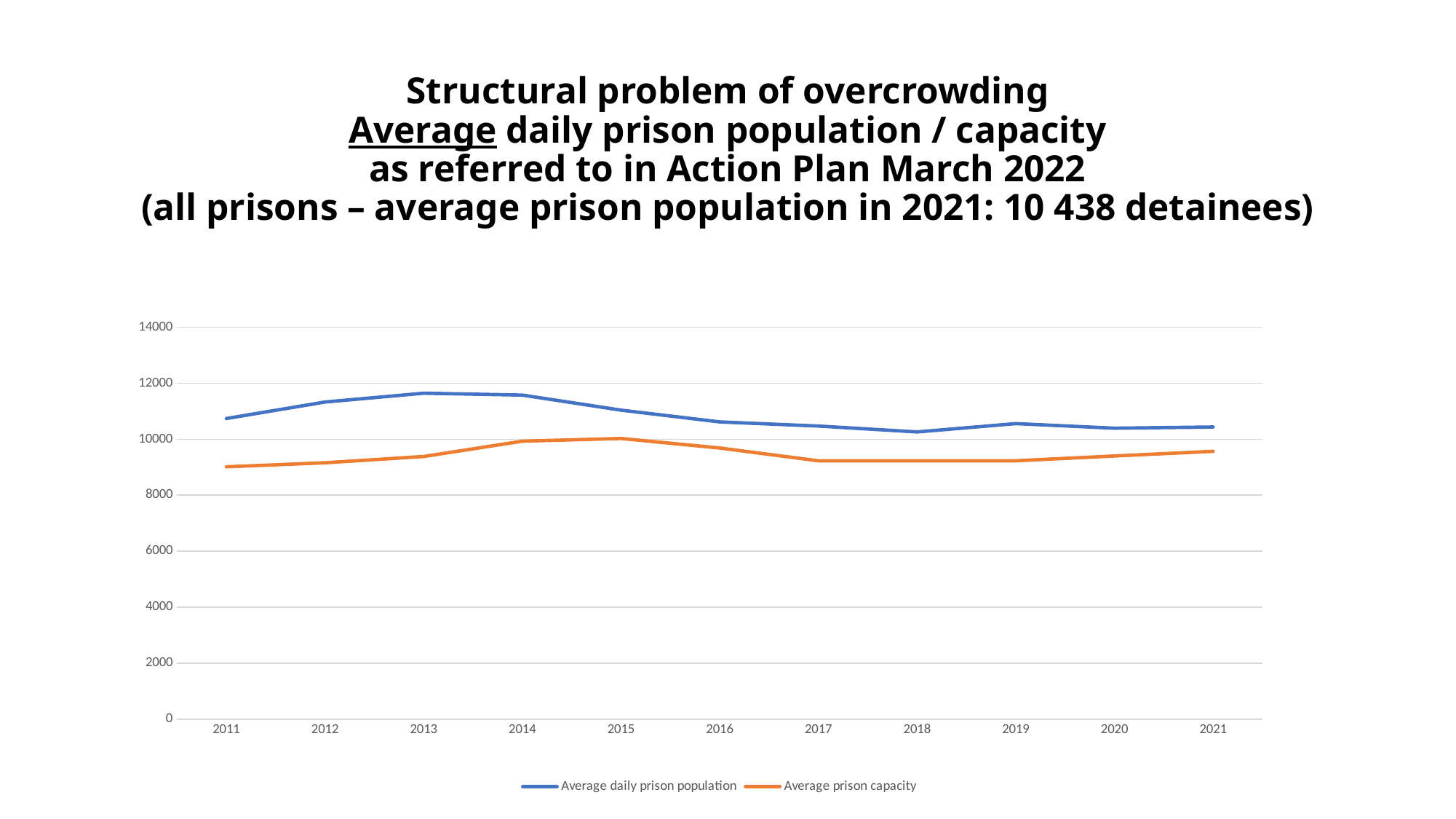
Is the Average prison capacity in 2017 greater or less than 10000? less In which year is the Average daily prison population lowest? 2018 How many years are shown on the x axis? 11 Is the Average daily prison population in 2013 greater or less than 10000? greater Is the Average prison capacity in 2011 greater or less than 10000? less What kind of chart is shown on the slide? line chart In which year is the Average prison capacity lowest? 2011 In 2013, which is larger: the Average daily prison population or the Average prison capacity? Average daily prison population What is the first year shown on the x axis? 2011 Which series is drawn in orange? Average prison capacity Does the Average daily prison population rise or fall from 2013 to 2018? fall How many series does the legend list? 2